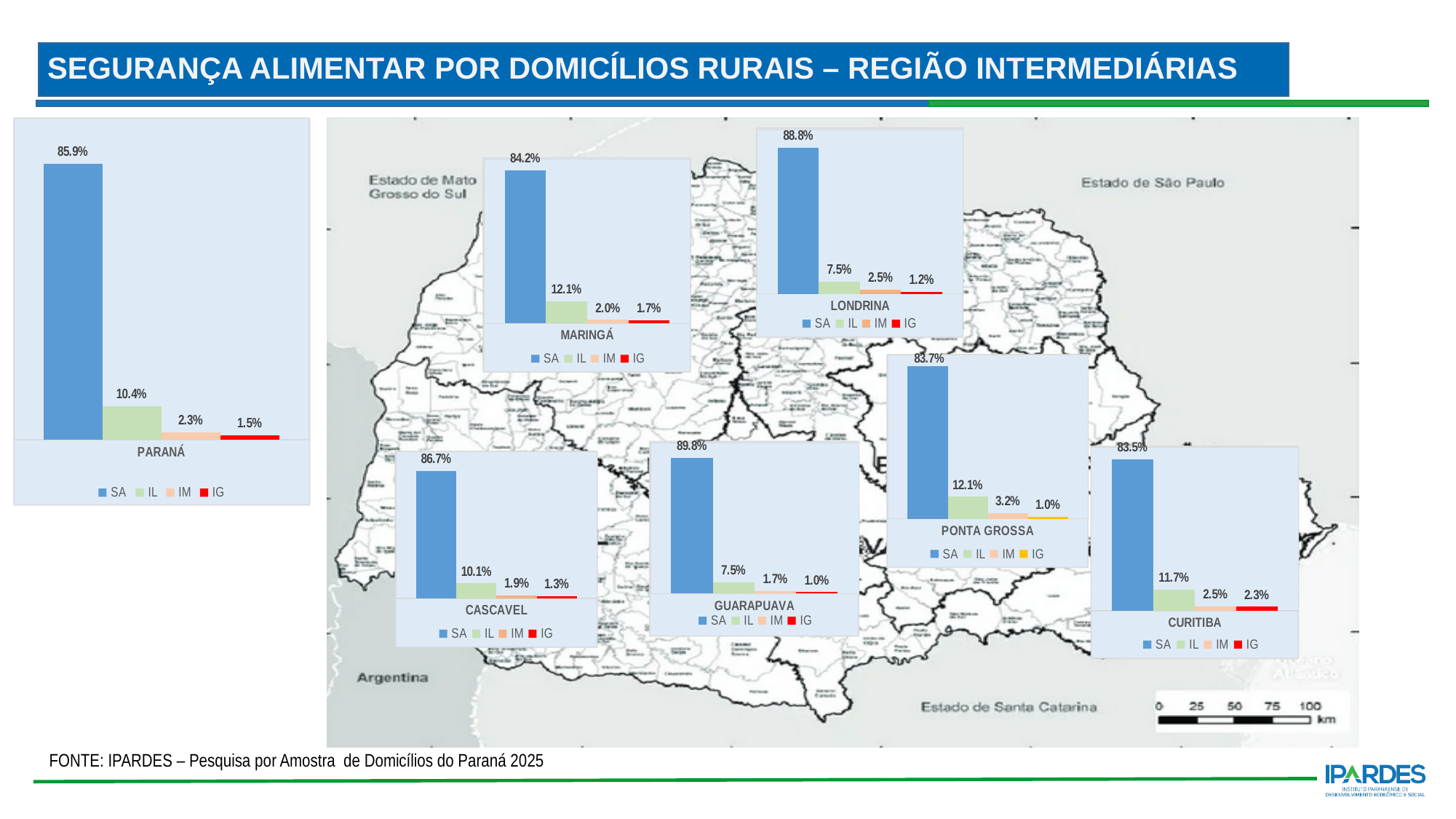
In the PARANÁ chart, what is the value for SA? 85.9% In the LONDRINA chart, what is the value for IL? 7.5% In the CURITIBA chart, what is the value for IG? 2.3% In the CASCAVEL chart, what is the difference between the SA value and the IL value? 76.6% Which is larger: the SA value in the GUARAPUAVA chart or the SA value in the LONDRINA chart? GUARAPUAVA How many regional charts (excluding PARANÁ) are placed on the map? 6 In the GUARAPUAVA chart, which series has the highest value? SA What kind of chart is the CURITIBA chart? Bar chart How many series does the legend of the PARANÁ chart list? 4 In the MARINGÁ chart, which series has the lowest value? IG In the PONTA GROSSA chart, what is the value for IM? 3.2% In the MARINGÁ chart, what is the difference between the IM value and the IG value? 0.3%